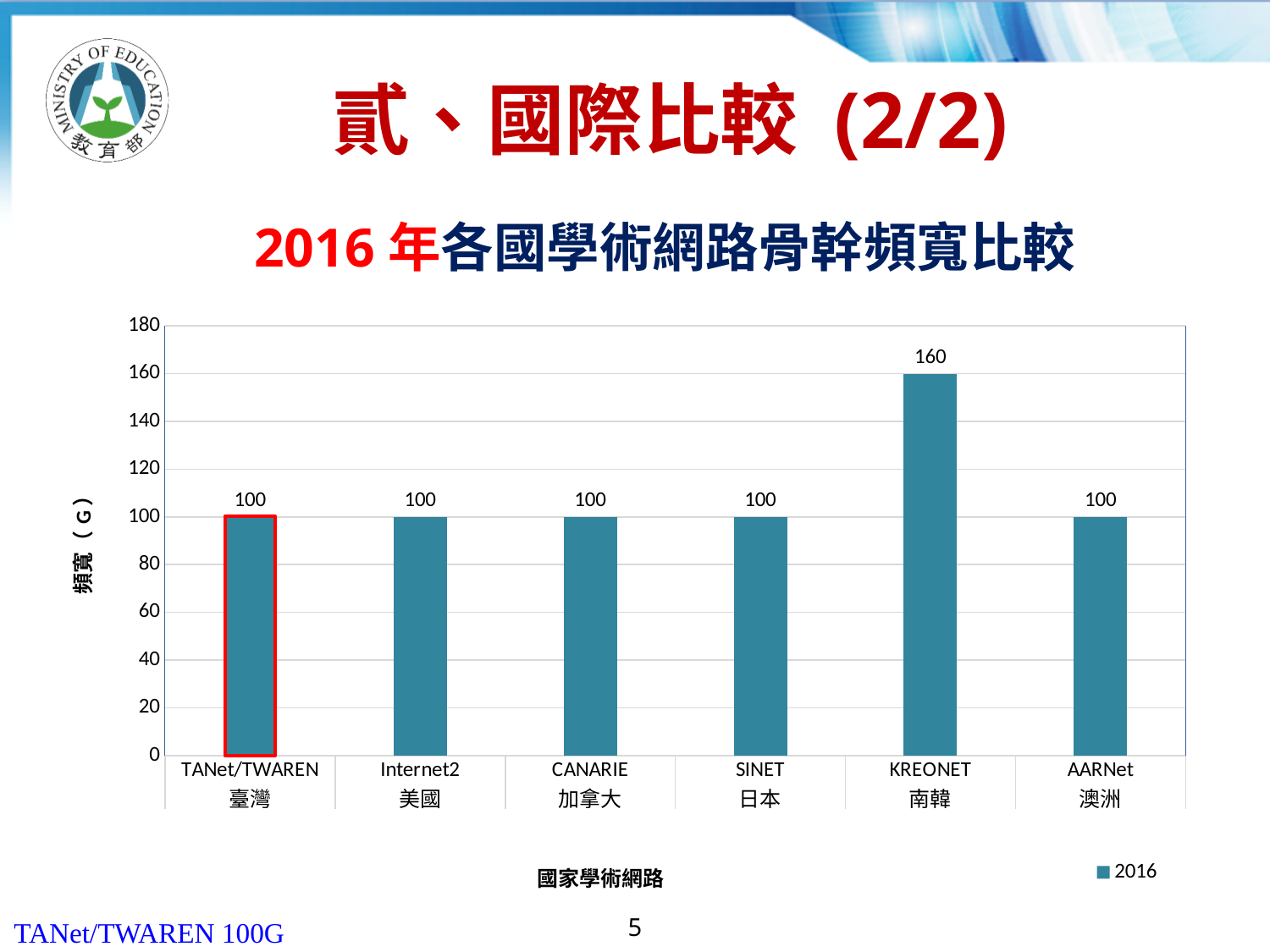
Which bar is outlined in red? TANet/TWAREN What is the value for SINET (日本)? 100 What is the value for KREONET (南韓)? 160 Which is larger, the value for KREONET or the value for AARNet? KREONET What is the difference between KREONET and Internet2? 60 How many series does the legend list? 1 What is the value for TANet/TWAREN (臺灣)? 100 How many networks are shown on the x axis? 6 Which network has the highest bandwidth? KREONET Is the value for KREONET greater or less than 140? greater What is the y-axis label? 頻寬（G） What kind of chart is shown? bar chart